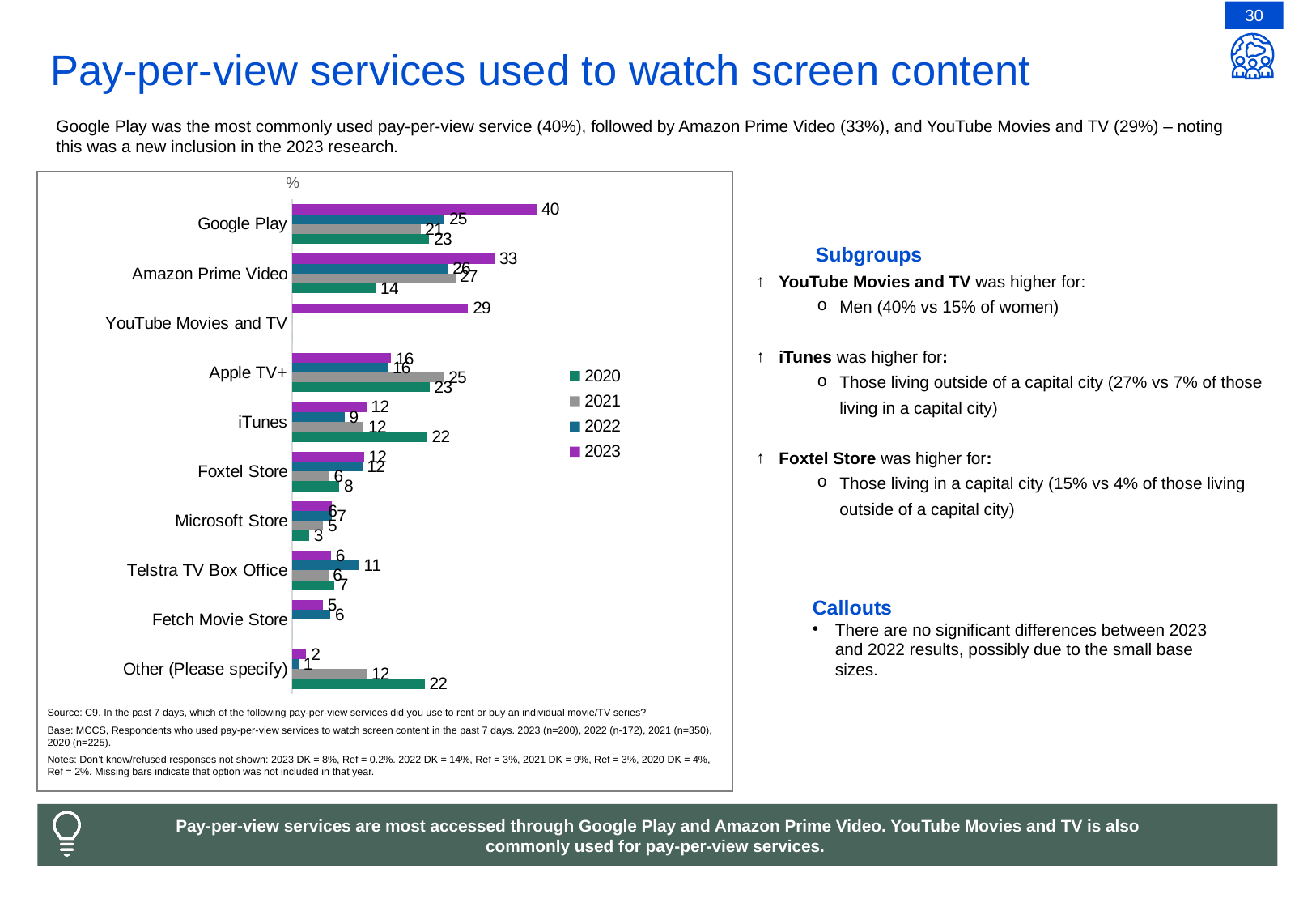
What was the value for Amazon Prime Video in 2020? 14 What was the value for YouTube Movies and TV in 2023? 29 What was the value for Other (Please specify) in 2020? 22 Which service had the highest value in 2023? Google Play What is the difference between the 2020 and 2023 values for iTunes? 10 How many series does the legend list? 4 What is the difference between the 2023 and 2022 values for Google Play? 15 What kind of chart is shown on the slide? Bar chart How many pay-per-view services are listed on the chart? 10 What was the value for Google Play in 2023? 40 Which had the larger 2021 value, Apple TV+ or iTunes? Apple TV+ Which service had the lowest value in 2020? Microsoft Store